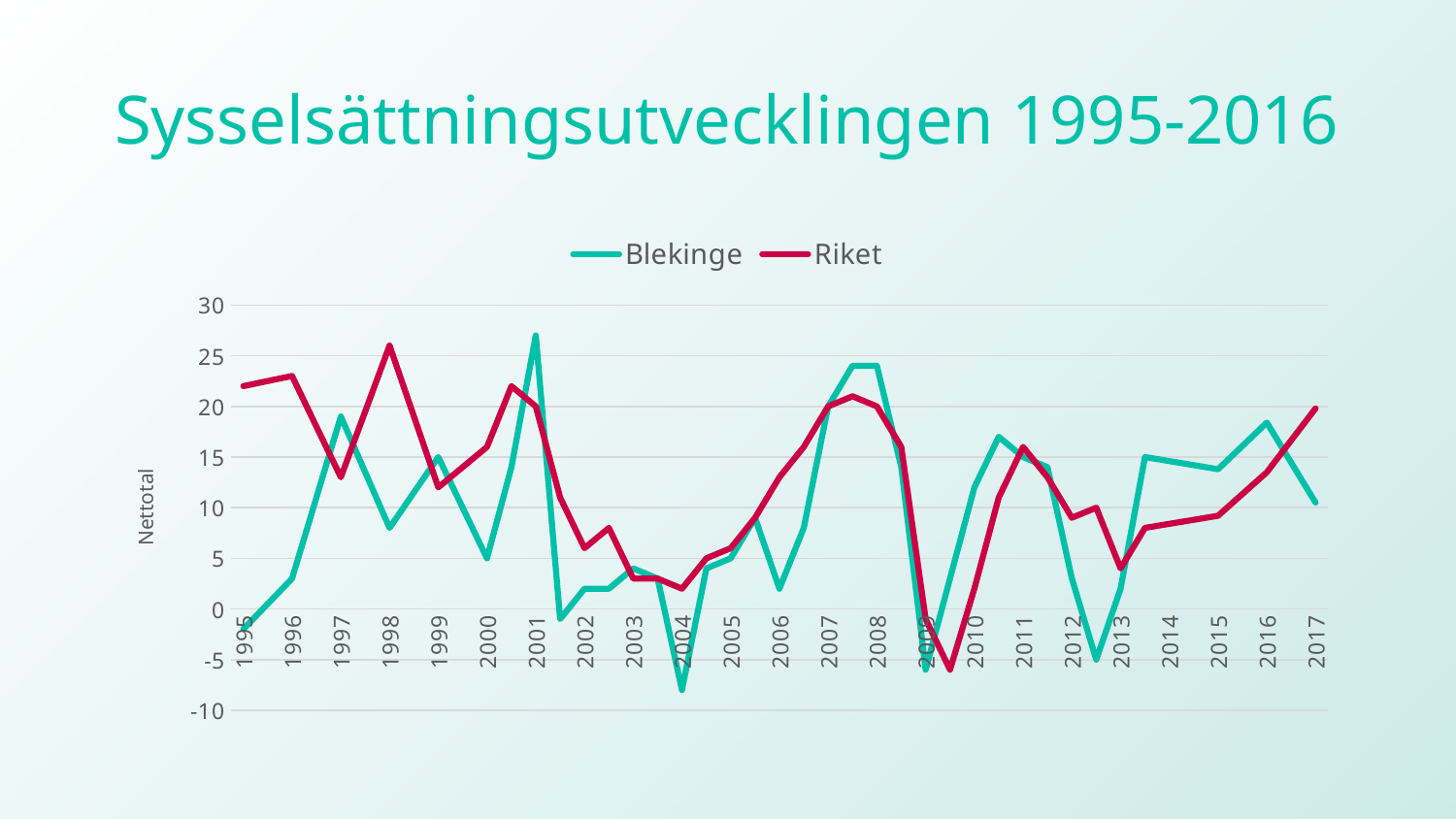
In which year does the Blekinge series reach its highest value? 2001 Is the value for Riket in 1995 greater or less than 20? greater In 2001, which series has the higher value, Blekinge or Riket? Blekinge How many series does the legend list? 2 What is the title of the chart? Sysselsättningsutvecklingen 1995-2016 Is the value for Blekinge in 2001 greater or less than 25? greater In 1998, which series has the higher value, Blekinge or Riket? Riket What kind of chart is shown on the slide? line chart What is the label on the vertical axis? Nettotal How many years are shown on the x axis? 23 Is the value for Blekinge in 2004 greater or less than -5? less